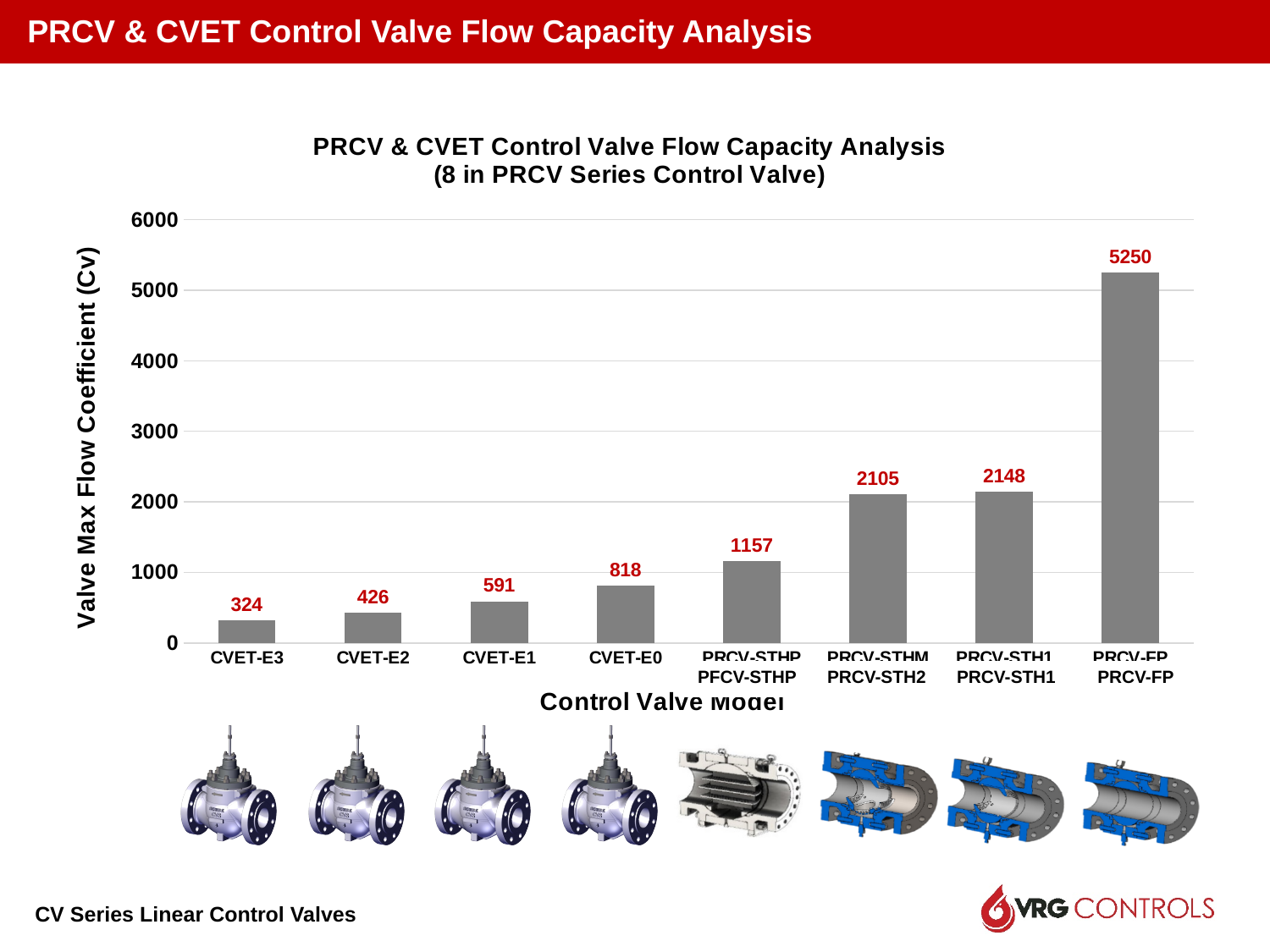
Do the values generally rise or fall from left to right along the x axis? rise How many control valve models are plotted in the chart? 8 What is the Valve Max Flow Coefficient (Cv) for PRCV-STH1? 2148 What is the Valve Max Flow Coefficient (Cv) for CVET-E1? 591 What is the Valve Max Flow Coefficient (Cv) for CVET-E3? 324 Which control valve model has the lowest Valve Max Flow Coefficient? CVET-E3 What is the Valve Max Flow Coefficient (Cv) for PRCV-FP? 5250 Which control valve model has the highest Valve Max Flow Coefficient? PRCV-FP What type of chart is shown on the slide? bar chart What is the difference in Valve Max Flow Coefficient between CVET-E0 and CVET-E2? 392 Is the value for PRCV-FP greater or less than 5000? greater Which has a larger Valve Max Flow Coefficient, CVET-E1 or CVET-E0? CVET-E0